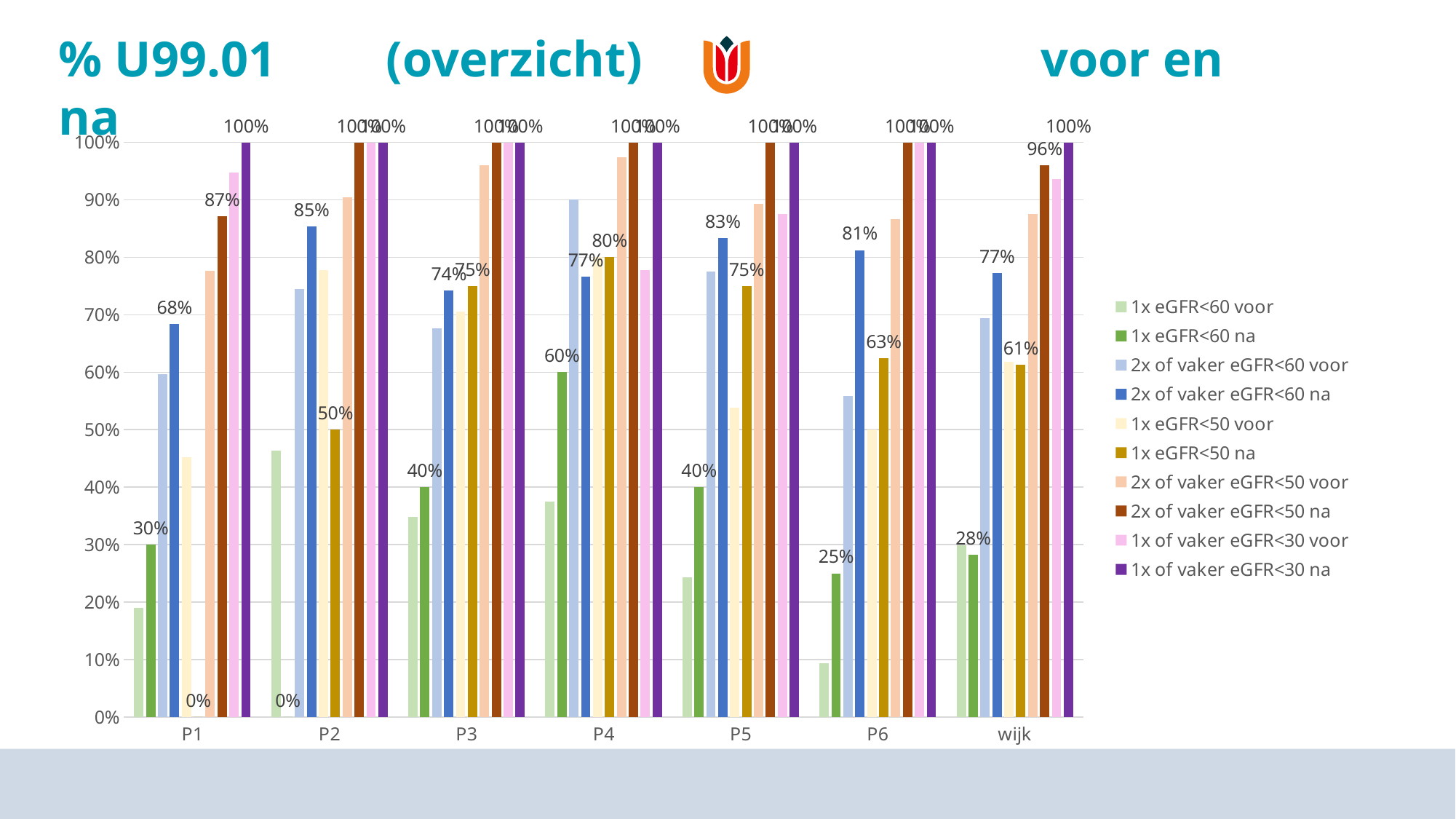
Which category has the highest value for '1x eGFR<60 na'? P4 What is the value for '1x eGFR<50 na' at P2? 50% What is the value for '2x of vaker eGFR<50 na' at wijk? 96% At P5, what is the difference between '2x of vaker eGFR<60 na' and '1x eGFR<50 na'? 8 percentage points What is the value for '1x eGFR<50 na' at P6? 63% What is the value for '2x of vaker eGFR<60 na' at P1? 68% How many categories are shown on the x axis? 7 How many series does the legend list? 10 Is the value for '2x of vaker eGFR<60 voor' at P4 greater or less than 80%? greater Which has the larger value for '2x of vaker eGFR<60 na', P3 or P6? P6 Is the value for '1x eGFR<60 voor' at P6 greater or less than 20%? less Which category has the lowest value for '1x eGFR<60 na'? P2